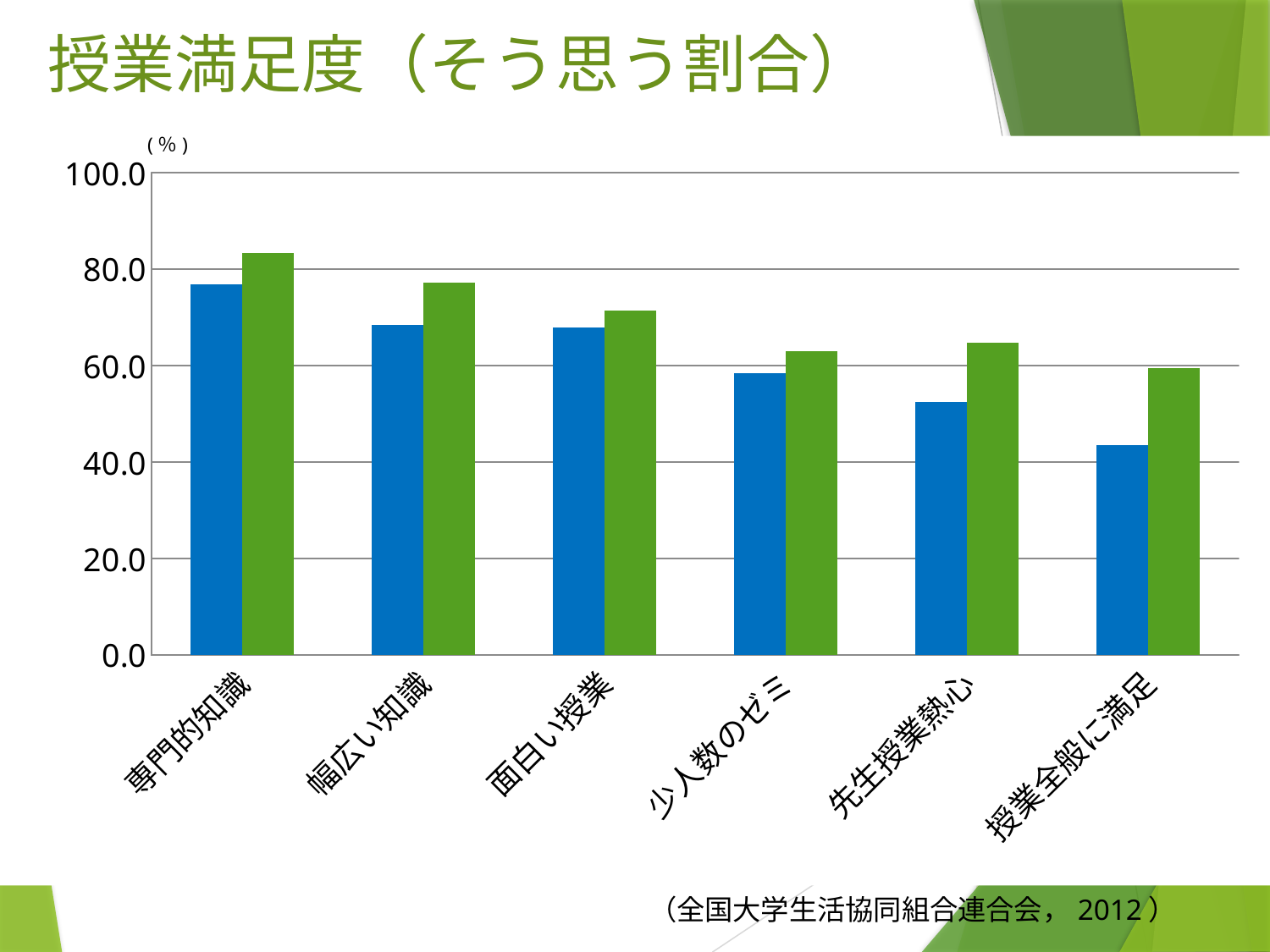
What is the title of the chart on the slide? 授業満足度（そう思う割合） For 専門的知識, which bar is taller, the blue one or the green one? green Which category has the lowest blue bar? 授業全般に満足 Is the blue bar for 先生授業熱心 greater or less than 60? less Is the green bar for 授業全般に満足 greater or less than 80? less Which category has the highest green bar? 専門的知識 Is the blue bar for 授業全般に満足 greater or less than 60? less How many bars are shown for each category in the chart? 2 What kind of chart is shown on the slide? bar chart How many categories are shown on the x axis of the chart? 6